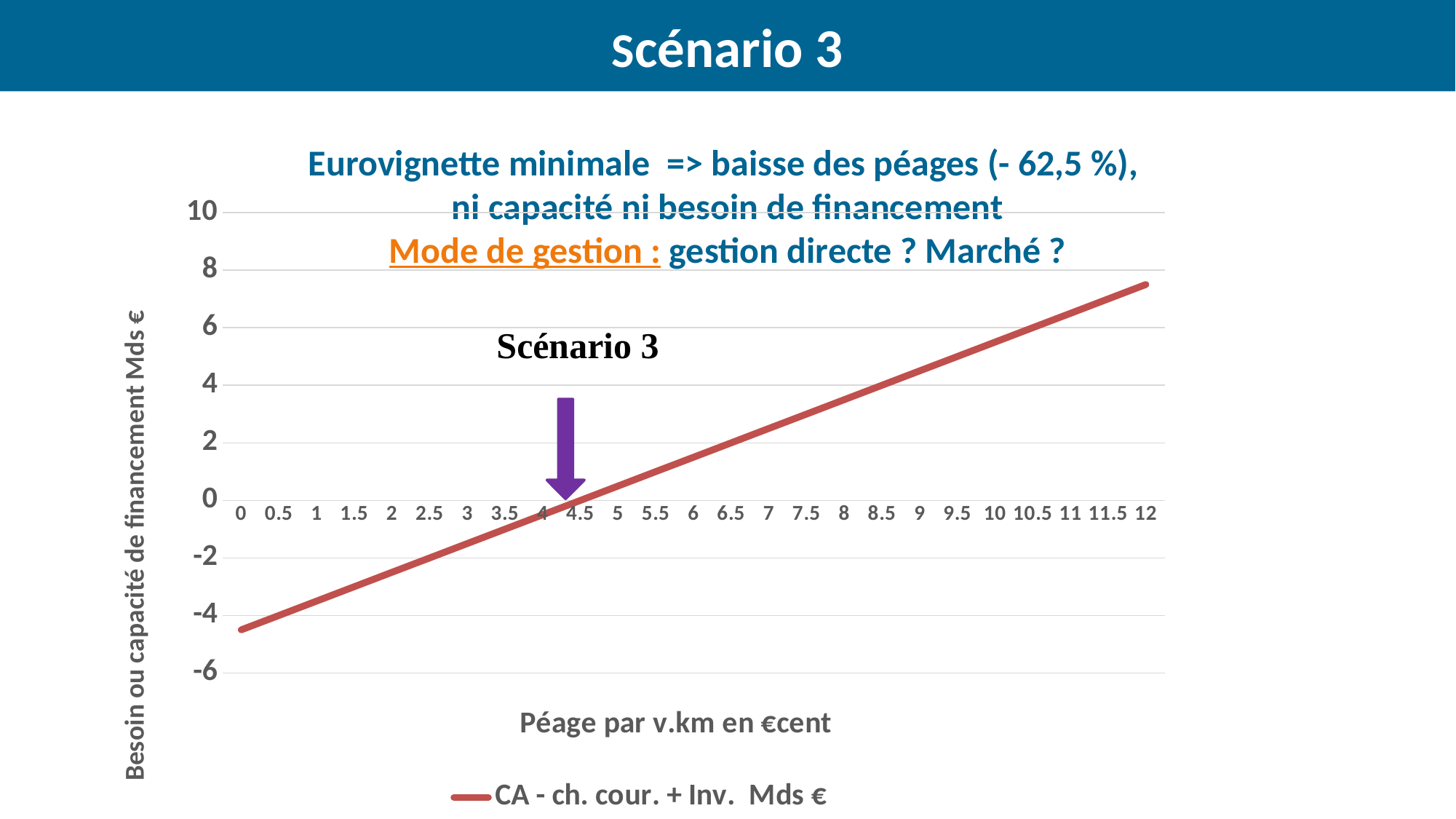
At which x-axis value is the line at its highest? 12 What kind of chart is shown on the slide? line chart Is the value of the line at a toll of 12 greater or less than 6? greater Which is larger, the value of the line at a toll of 2 or at a toll of 10? 10 What is the title of the x axis? Péage par v.km en €cent At which x-axis value is the line at its lowest? 0 How many series does the legend list? 1 What is the name of the series shown in the legend? CA - ch. cour. + Inv. Mds € Is the value of the line at a toll of 0 greater or less than -4? less Is the value of the line at a toll of 8 greater or less than 2? greater Do the values of the line rise or fall as the toll per v.km increases along the x axis? rise How many tick labels are shown on the x axis? 25